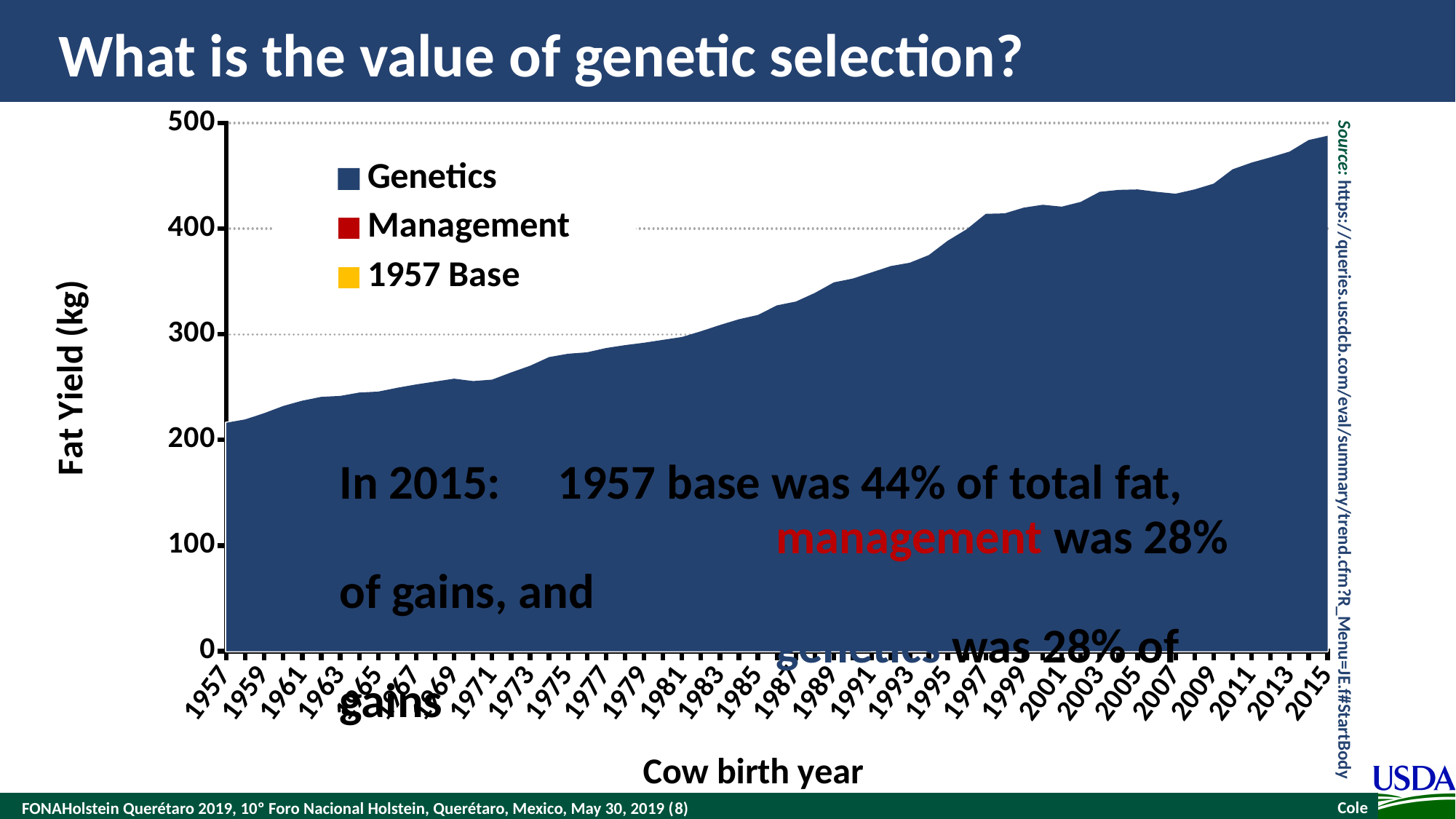
What is the title of the y axis? Fat Yield (kg) Which cow birth year has the lowest fat yield? 1957 Is the fat yield for cow birth year 2015 greater or less than 400? greater Does fat yield rise or fall as cow birth year increases from 1957 to 2015? Rise Is the fat yield for cow birth year 2009 greater or less than 400? greater Is the fat yield for cow birth year 1975 greater or less than 300? less Which cow birth year has the highest fat yield? 2015 Which has the larger fat yield, cow birth year 1965 or cow birth year 1995? 1995 How many series does the chart legend list? 3 Which series are listed in the chart legend? Genetics, Management, 1957 Base What kind of chart is shown on the slide? Area chart